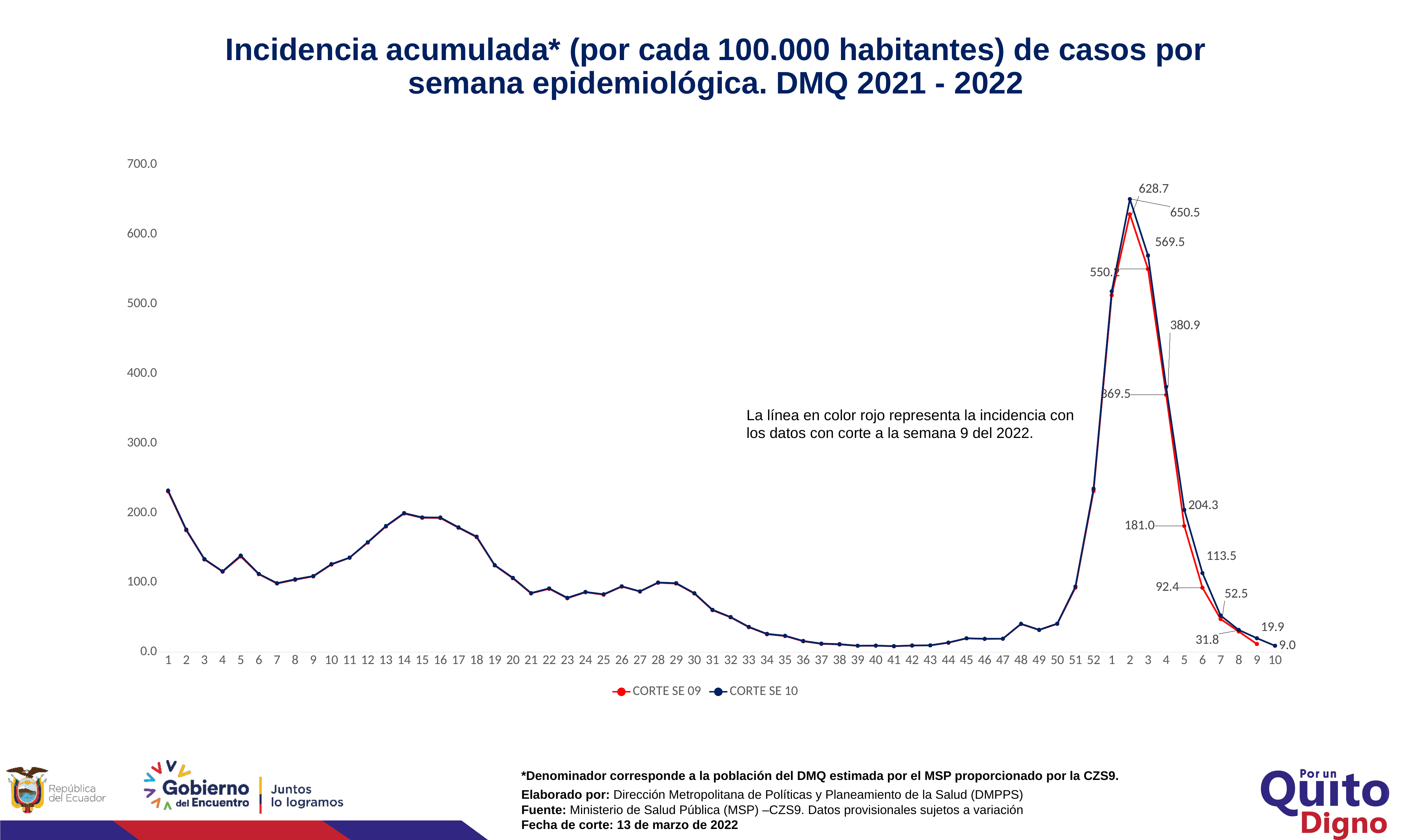
What are the two series named in the legend? CORTE SE 09 and CORTE SE 10 What is the value of CORTE SE 10 at week 4 of 2022? 380.9 What is the difference between the CORTE SE 10 and CORTE SE 09 values at week 2 of 2022? 21.8 What is the value of CORTE SE 10 at week 2 of 2022? 650.5 How many series does the legend list? 2 At which epidemiological week does the CORTE SE 10 series reach its highest value? Week 2 of 2022 At week 5 of 2022, which series has the larger value, CORTE SE 09 or CORTE SE 10? CORTE SE 10 Is the value at week 40 of 2021 greater or less than 100.0? less What is the value of CORTE SE 10 at week 10 of 2022? 9.0 What is the value of CORTE SE 09 at week 2 of 2022? 628.7 What colour is the CORTE SE 09 line? Red What kind of chart is shown on the slide? Line chart